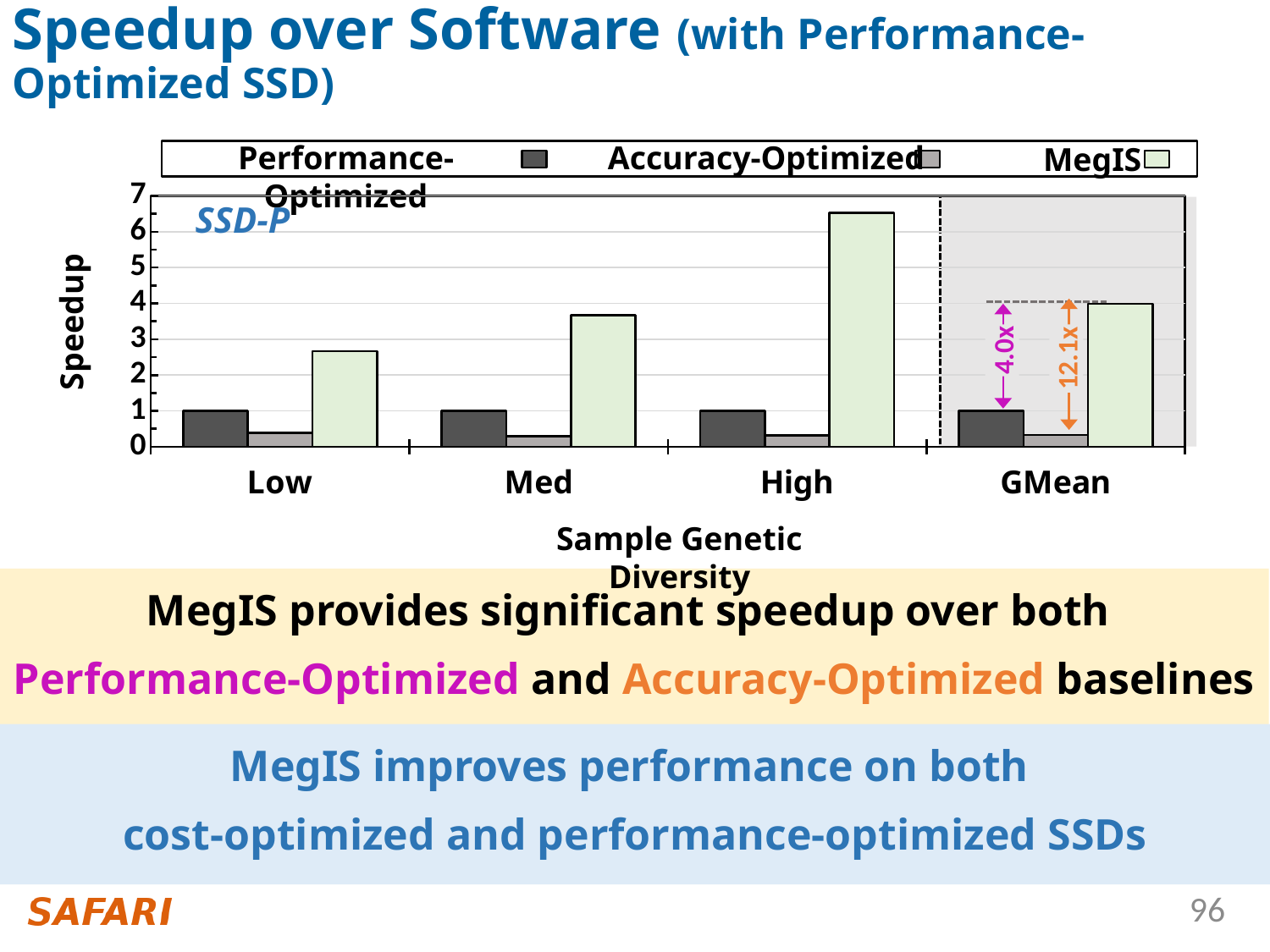
According to the annotation, what is MegIS's speedup over the Accuracy-Optimized baseline at GMean? 12.1x How many categories are shown on the x axis? 4 Which category has the highest MegIS speedup? High Do the MegIS speedup values rise or fall from Low to High? rise Which is larger for Med: the MegIS speedup or the Performance-Optimized speedup? MegIS Is the MegIS speedup for Low greater or less than 3? less What is the MegIS speedup for GMean? 4.0x Is the Accuracy-Optimized speedup for Med greater or less than 1? less What kind of chart is shown on the slide? bar chart Is the MegIS speedup for High greater or less than 6? greater How many series does the legend list? 3 Which category has the lowest MegIS speedup? Low